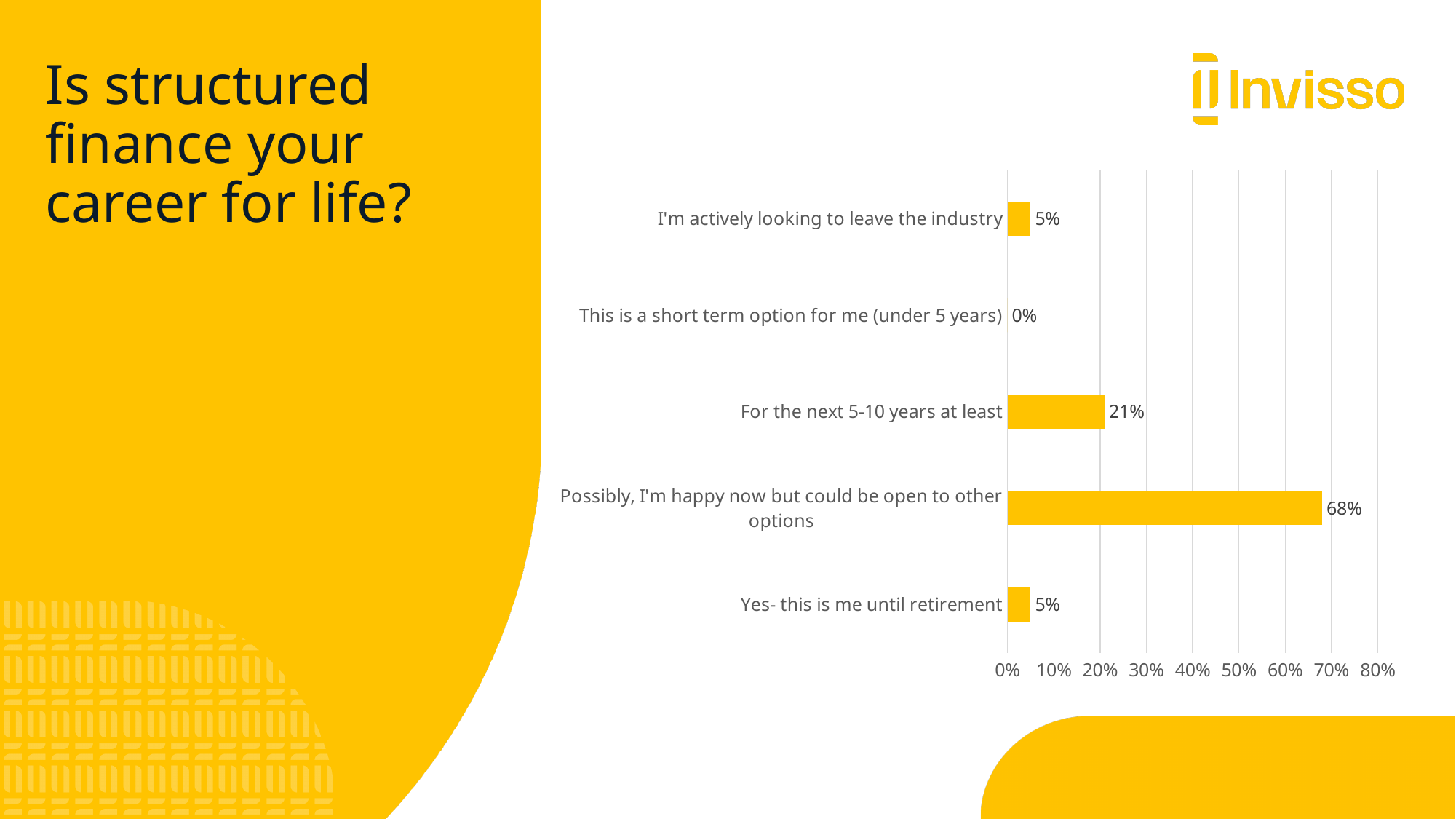
What kind of chart is shown on the slide? Bar chart Which response has the highest percentage? Possibly, I'm happy now but could be open to other options What is the difference between the 'Possibly, I'm happy now but could be open to other options' value and the 'For the next 5-10 years at least' value? 47% What is the value for 'For the next 5-10 years at least'? 21% What percentage of respondents said 'Possibly, I'm happy now but could be open to other options'? 68% Is the value for 'Possibly, I'm happy now but could be open to other options' greater or less than 60%? greater Which response has the lowest percentage? This is a short term option for me (under 5 years) How many response categories are shown in the chart? 5 What percentage of respondents are actively looking to leave the industry? 5% What is the title of the slide containing the chart? Is structured finance your career for life? What is the value for 'This is a short term option for me (under 5 years)'? 0% Which is larger: 'For the next 5-10 years at least' or 'Yes- this is me until retirement'? For the next 5-10 years at least